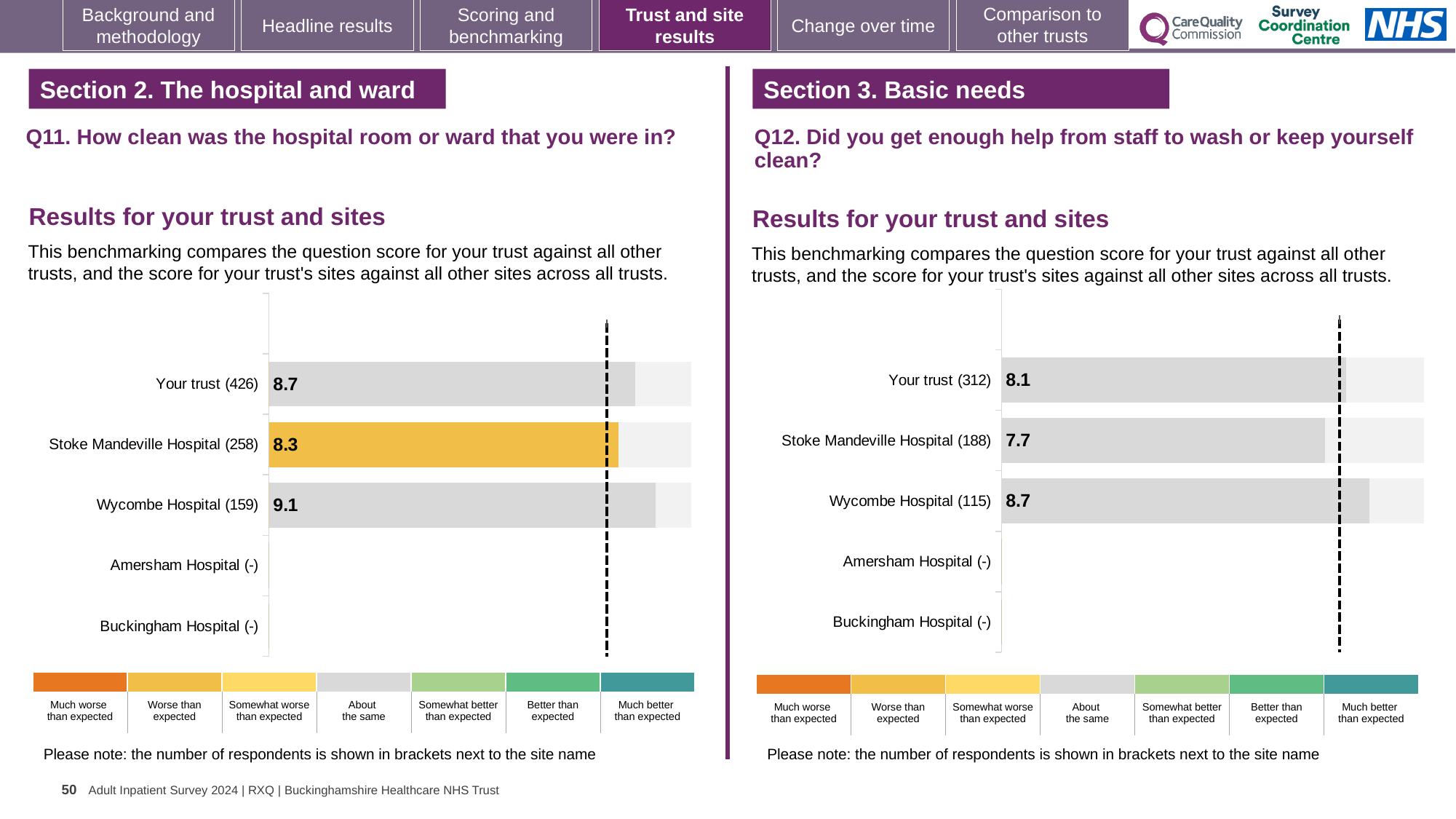
In the Q11 chart on the left, what is the score for Wycombe Hospital (159)? 9.1 In the Q12 chart on the right, what is the score for Stoke Mandeville Hospital (188)? 7.7 In the Q12 chart on the right, is the score for Wycombe Hospital larger or smaller than the score for Your trust? larger In the Q11 chart on the left, what is the difference between the scores for Wycombe Hospital and Stoke Mandeville Hospital? 0.8 In the Q11 chart on the left, which bar is coloured yellow/orange rather than grey? Stoke Mandeville Hospital (258) In the Q11 chart on the left, which site has the highest score? Wycombe Hospital (159) What kind of chart is used for the Q12 results on the right? bar chart In the Q12 chart on the right, which site has the lowest score? Stoke Mandeville Hospital (188) How many site/trust rows are listed on the y axis of the Q11 chart on the left? 5 In the Q12 chart on the right, what is the difference between the scores for Wycombe Hospital and Your trust? 0.6 In the Q12 chart on the right, what is the score for Your trust (312)? 8.1 In the Q11 chart on the left, what is the score for Your trust (426)? 8.7